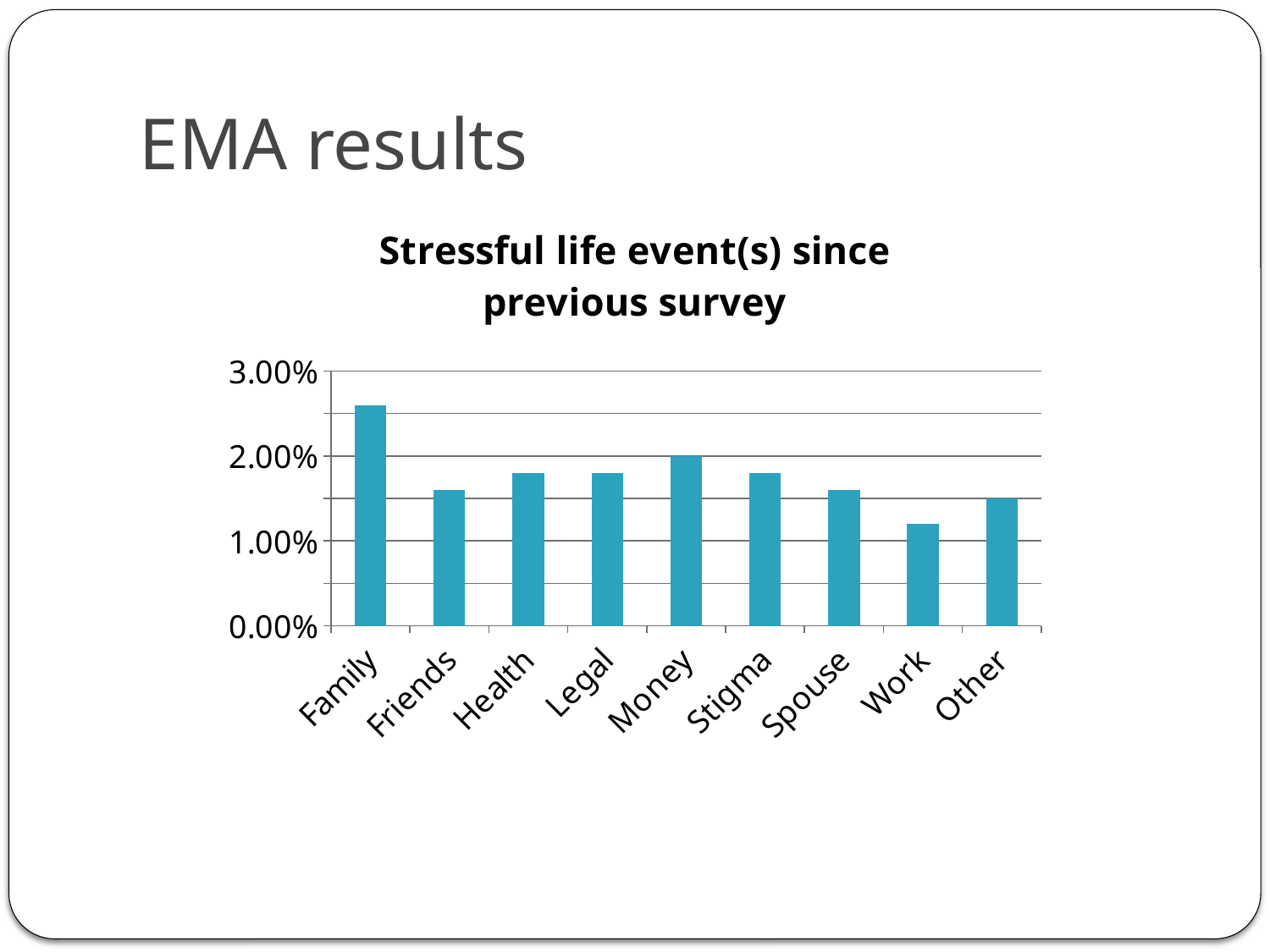
Which is larger, the value for Family or the value for Work? Family Is the value for Family greater or less than 3.00%? less How many categories are shown on the x axis of the chart? 9 What is the title of the chart? Stressful life event(s) since previous survey What is the highest value labelled on the vertical axis of the chart? 3.00% Is the value for Friends greater or less than 2.00%? less Is the value for Work greater or less than 1.00%? greater Which category has the highest value in the chart? Family Which category has the lowest value in the chart? Work What kind of chart is shown on the slide? bar chart Which is larger, the value for Money or the value for Friends? Money